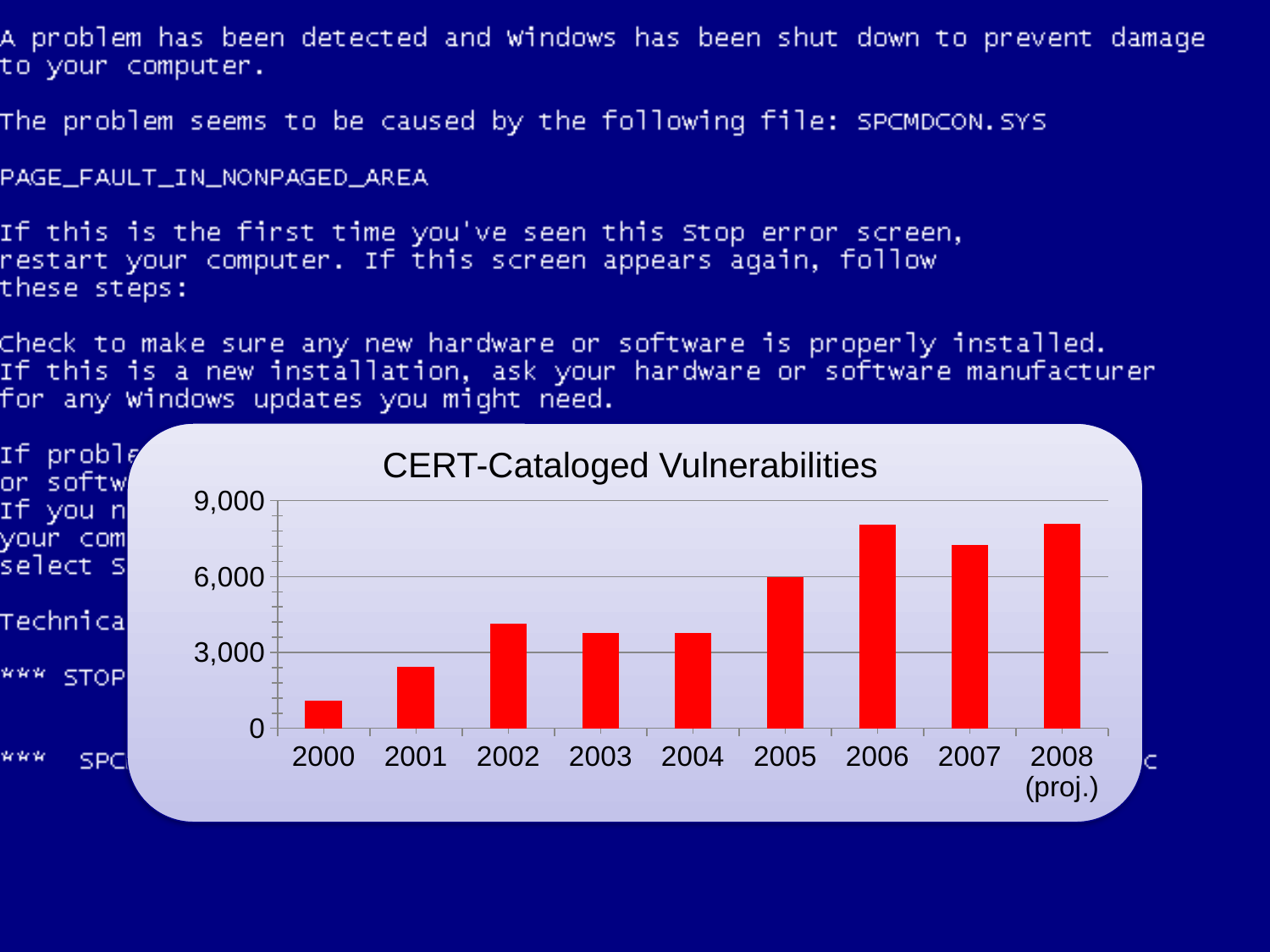
Is the value for 2000 greater or less than 3,000? less What colour are the bars in the chart? red Which year has the larger value, 2001 or 2002? 2002 Is the value for 2002 greater or less than 3,000? greater How many years are shown on the x axis of the chart? 9 Which year has the lowest number of CERT-cataloged vulnerabilities? 2000 What kind of chart is shown on the slide? bar chart Which year has the larger value, 2006 or 2007? 2006 Do the values generally rise or fall from 2000 to 2008? rise Is the value for 2007 greater or less than 9,000? less What is the title of the chart? CERT-Cataloged Vulnerabilities